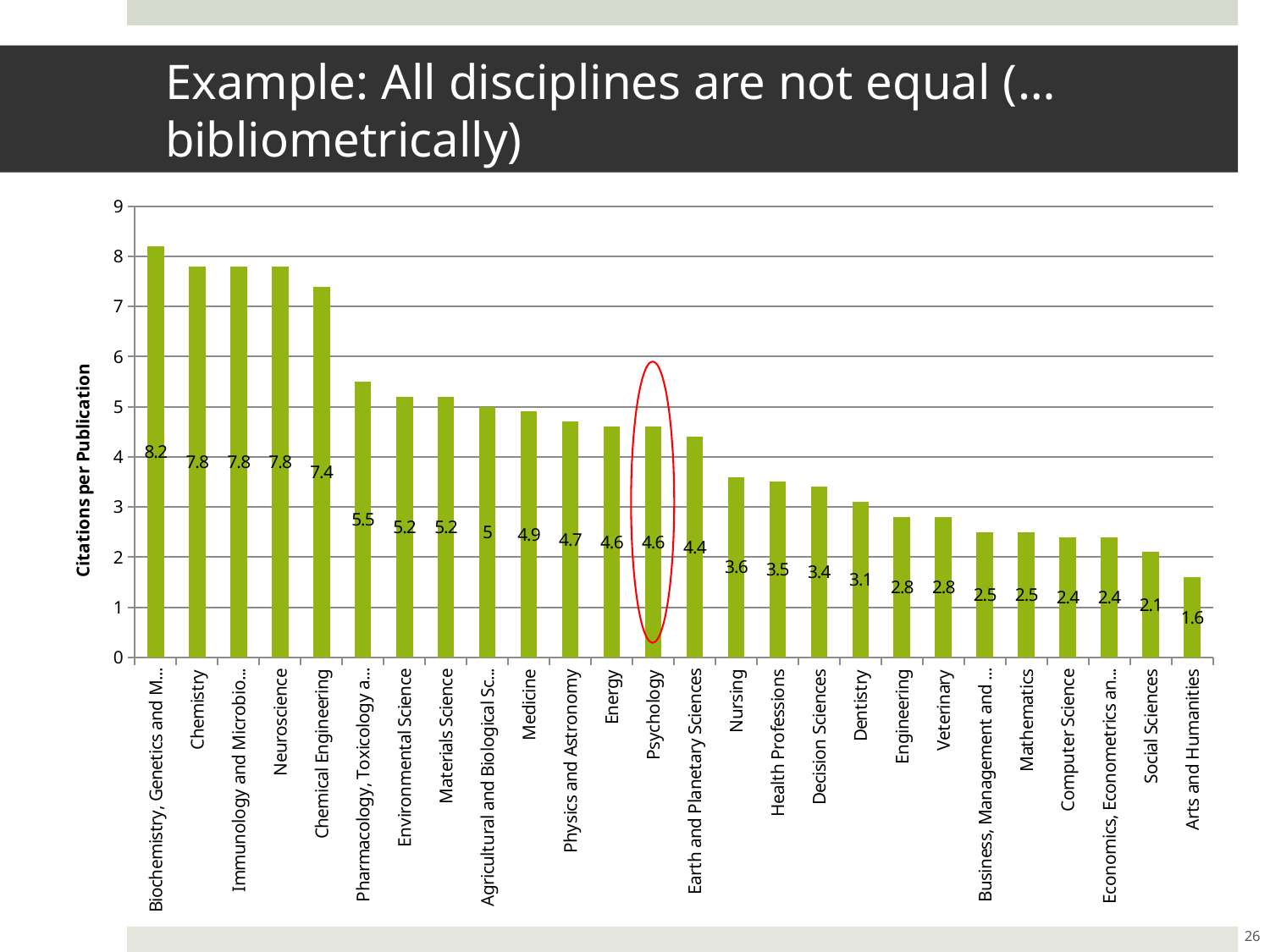
What is the citations per publication value for Psychology? 4.6 What is the citations per publication value for Dentistry? 3.1 Which discipline has the lowest citations per publication? Arts and Humanities What is the citations per publication value for Neuroscience? 7.8 How many disciplines are plotted in the chart? 26 What is the citations per publication value for Medicine? 4.9 What is the difference in citations per publication between Chemistry and Social Sciences? 5.7 What is the highest citations per publication value shown in the chart? 8.2 Do the values generally rise or fall from left to right along the x axis? fall Which has a higher citations per publication value, Nursing or Engineering? Nursing What is the label of the vertical axis? Citations per Publication What kind of chart is shown on the slide? bar chart